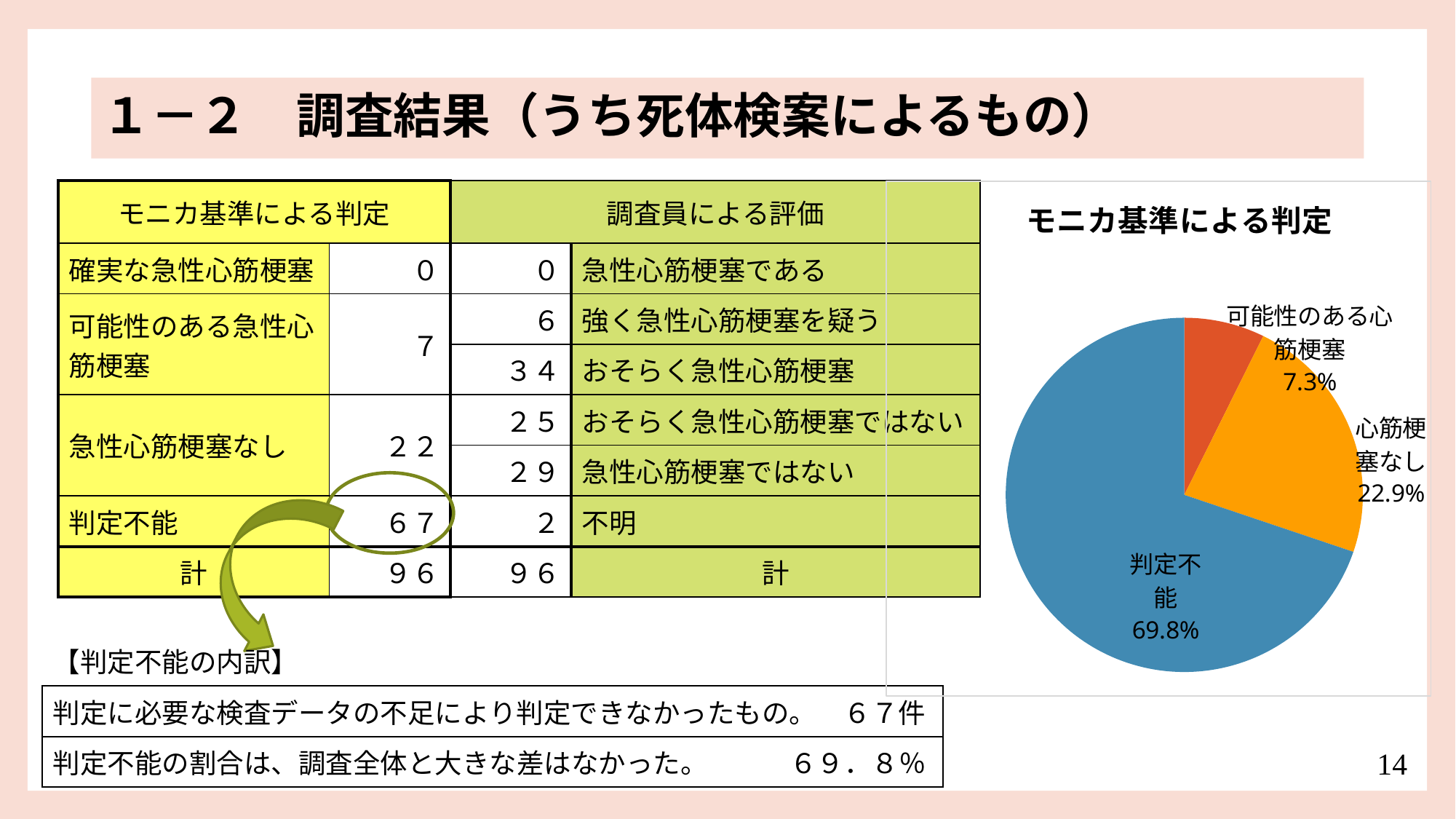
Which slice of the pie chart is the smallest? 可能性のある心筋梗塞 What is the difference in percentage points between the 判定不能 slice and the 心筋梗塞なし slice? 46.9 What is the title of the pie chart? モニカ基準による判定 How many slices does the pie chart have? 3 What kind of chart is shown on the slide? pie chart Which is larger in the pie chart, 心筋梗塞なし or 可能性のある心筋梗塞? 心筋梗塞なし What is the difference in percentage points between the 心筋梗塞なし slice and the 可能性のある心筋梗塞 slice? 15.6 What share of the pie chart is labelled 可能性のある心筋梗塞? 7.3% What colour is the 判定不能 slice in the pie chart? blue Which slice of the pie chart is the largest? 判定不能 What share of the pie chart is labelled 心筋梗塞なし? 22.9% What share of the pie chart is labelled 判定不能? 69.8%